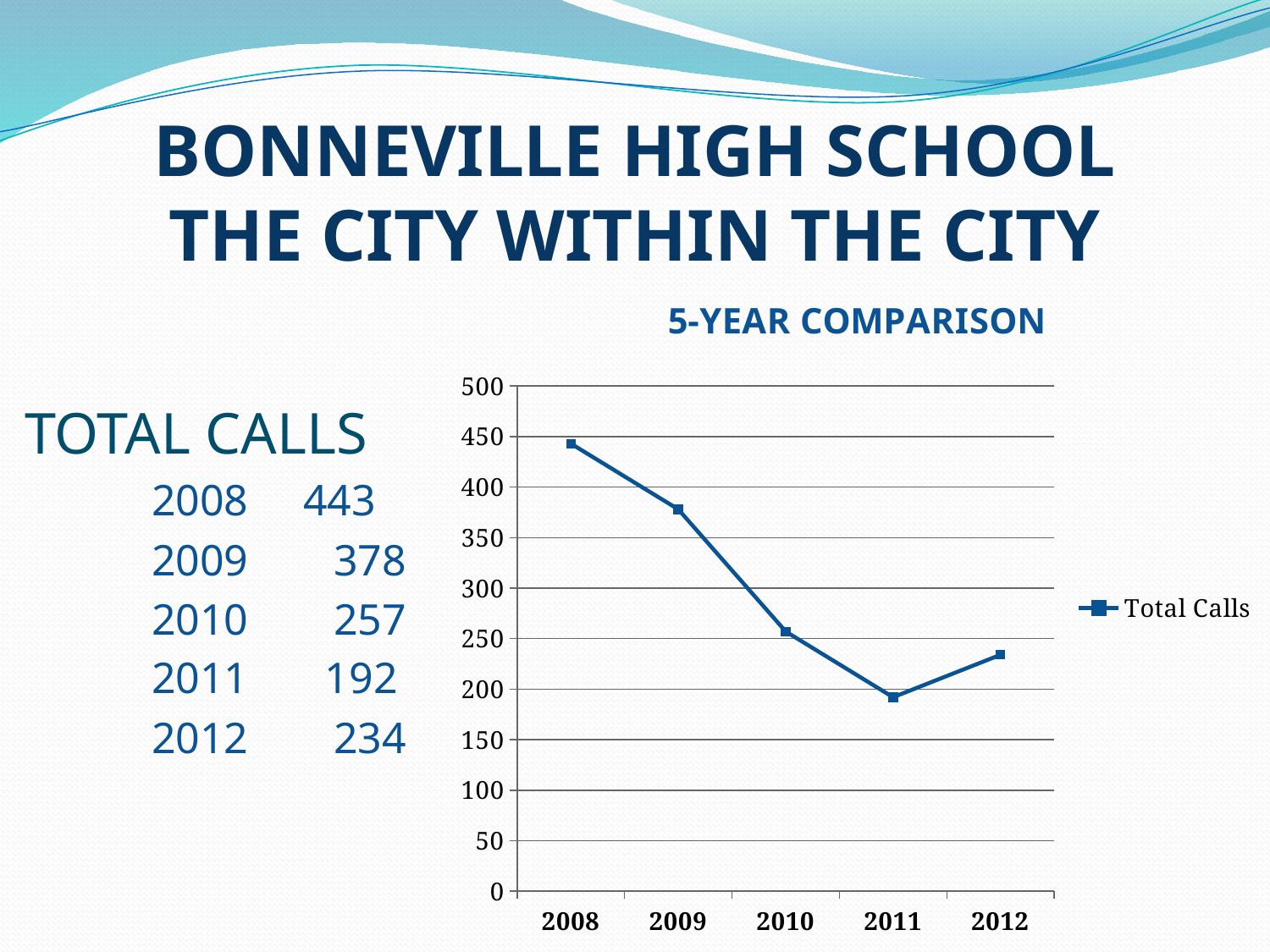
What is the value of Total Calls for 2008? 443 What is the value of Total Calls for 2011? 192 What is the difference in Total Calls between 2008 and 2009? 65 What kind of chart is shown on the slide? line chart Is the value for 2009 greater or less than 350? greater How many years are plotted on the x axis? 5 Which year has the highest number of Total Calls? 2008 What is the value of Total Calls for 2012? 234 Which year has more Total Calls, 2010 or 2012? 2010 How many series does the legend list? 1 Which year has the lowest number of Total Calls? 2011 What is the difference in Total Calls between 2010 and 2011? 65